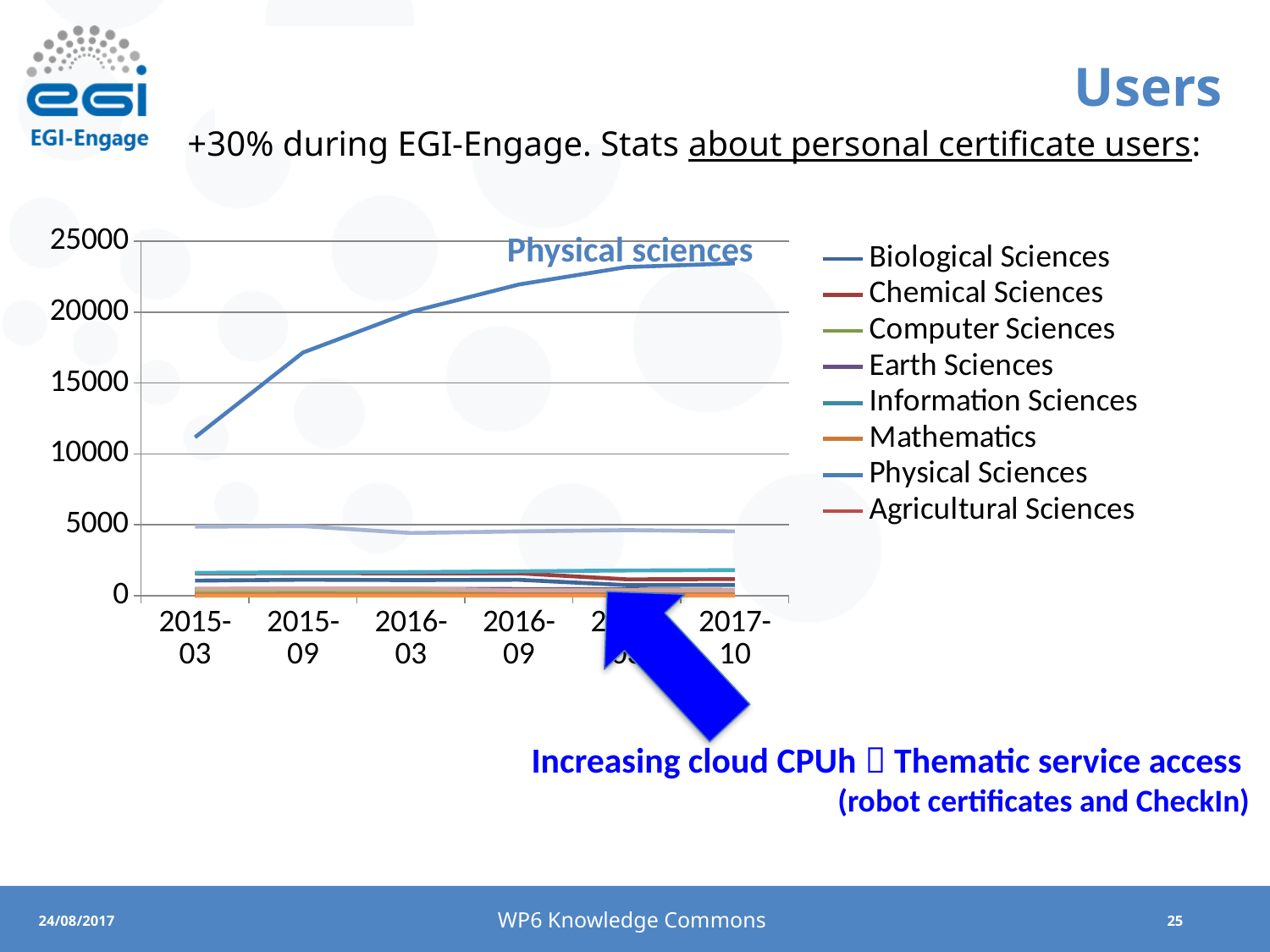
Is the value of the line labelled Physical sciences at 2015-03 greater or less than 15000? less Is the value of the line labelled Physical sciences at 2015-03 greater or less than 10000? greater Is the value of the line labelled Physical sciences at 2017-10 greater or less than 20000? greater What kind of chart is shown on the slide? line chart Does the line labelled Physical sciences rise or fall from 2015-03 to 2017-10? rise How many series does the chart legend list? 8 How many time points are shown on the x axis? 6 What is the highest value shown on the y axis? 25000 What is the first entry in the chart legend? Biological Sciences Which series has the highest values across the whole chart? Physical Sciences